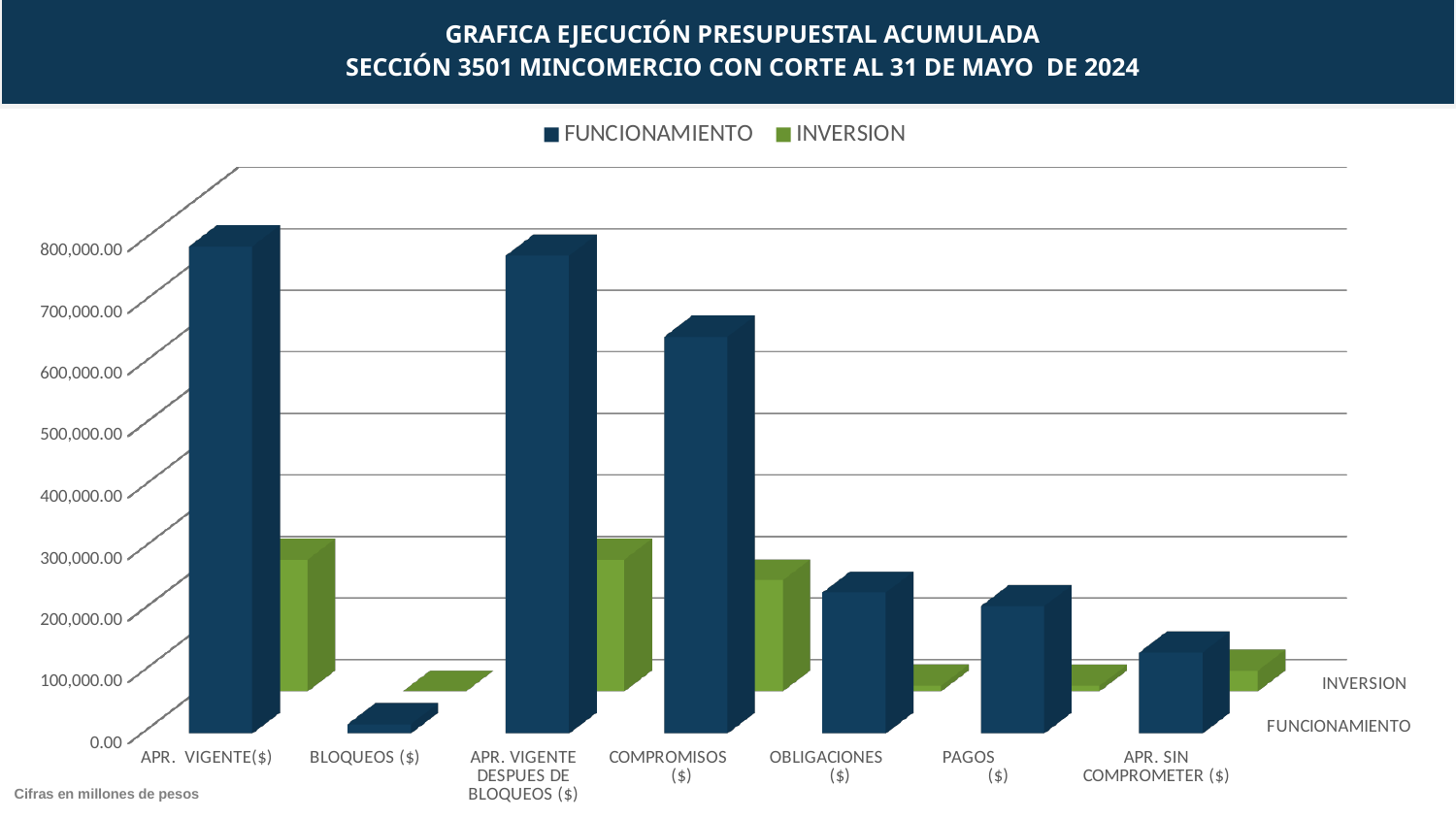
Which has the larger FUNCIONAMIENTO value, COMPROMISOS ($) or OBLIGACIONES ($)? COMPROMISOS ($) Which category has the lowest INVERSION value? BLOQUEOS ($) What kind of chart is shown on the slide? bar chart Which category has the lowest FUNCIONAMIENTO value? BLOQUEOS ($) Is the INVERSION value for APR. VIGENTE($) greater or less than 400,000.00? less How many series does the legend list? 2 Is the FUNCIONAMIENTO value for APR. VIGENTE($) greater or less than 700,000.00? greater Is the FUNCIONAMIENTO value for APR. SIN COMPROMETER ($) greater or less than 200,000.00? less How many categories are shown on the x axis? 7 For APR. VIGENTE($), which series has the larger value, FUNCIONAMIENTO or INVERSION? FUNCIONAMIENTO Which series is shown in green in the legend? INVERSION